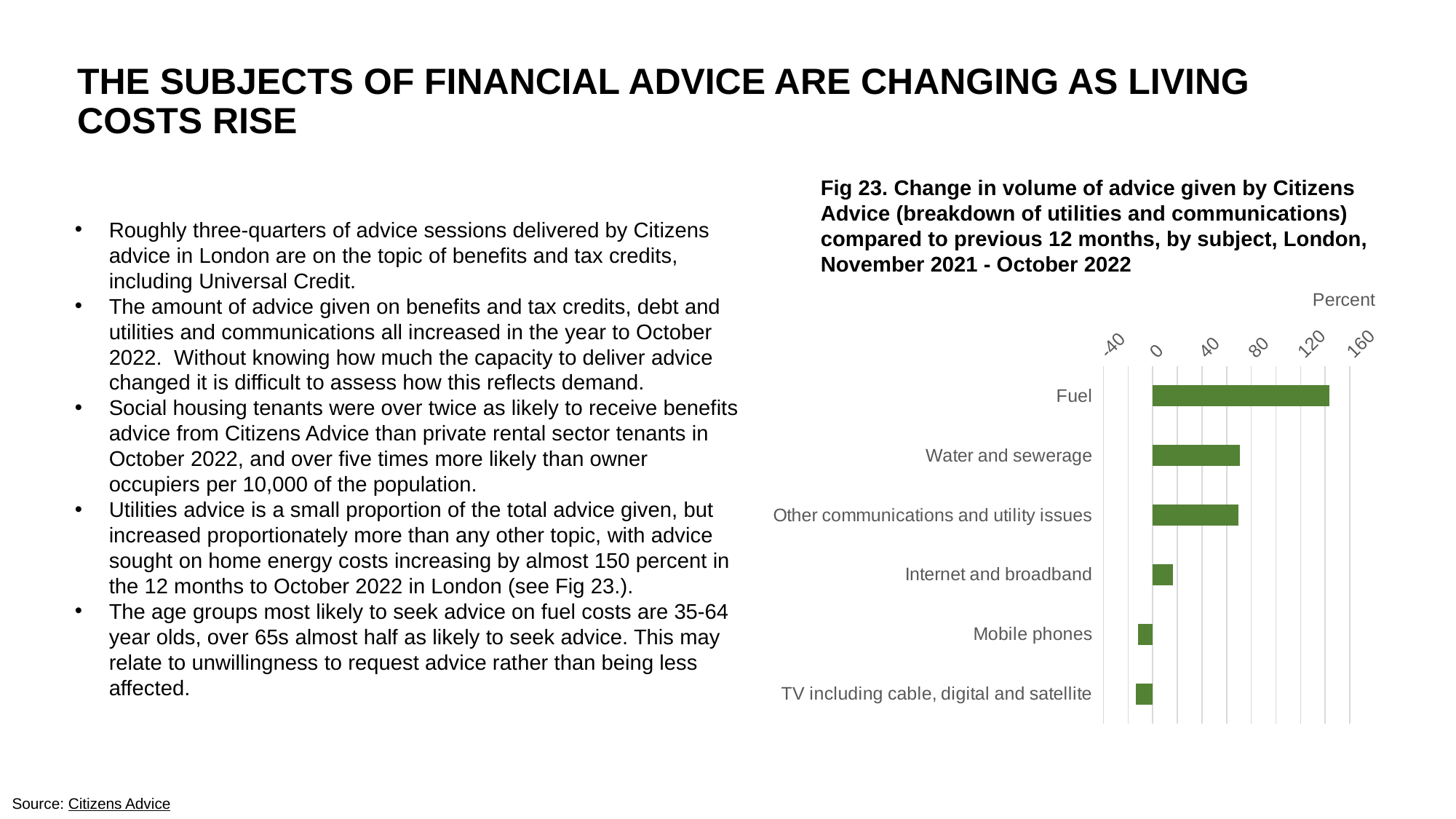
What unit is shown on the axis label of the Fig 23 chart? Percent Is the value for TV including cable, digital and satellite greater or less than 0? less What colour are the bars in the Fig 23 chart? Green Is the value for Other communications and utility issues greater or less than 40? greater Is the value for Water and sewerage greater or less than 80? less Which is larger, the value for Fuel or the value for Water and sewerage? Fuel Which subject has the highest change in volume of advice in the Fig 23 chart? Fuel What kind of chart is shown in Fig 23? Bar chart How many subject categories are plotted in the Fig 23 chart? 6